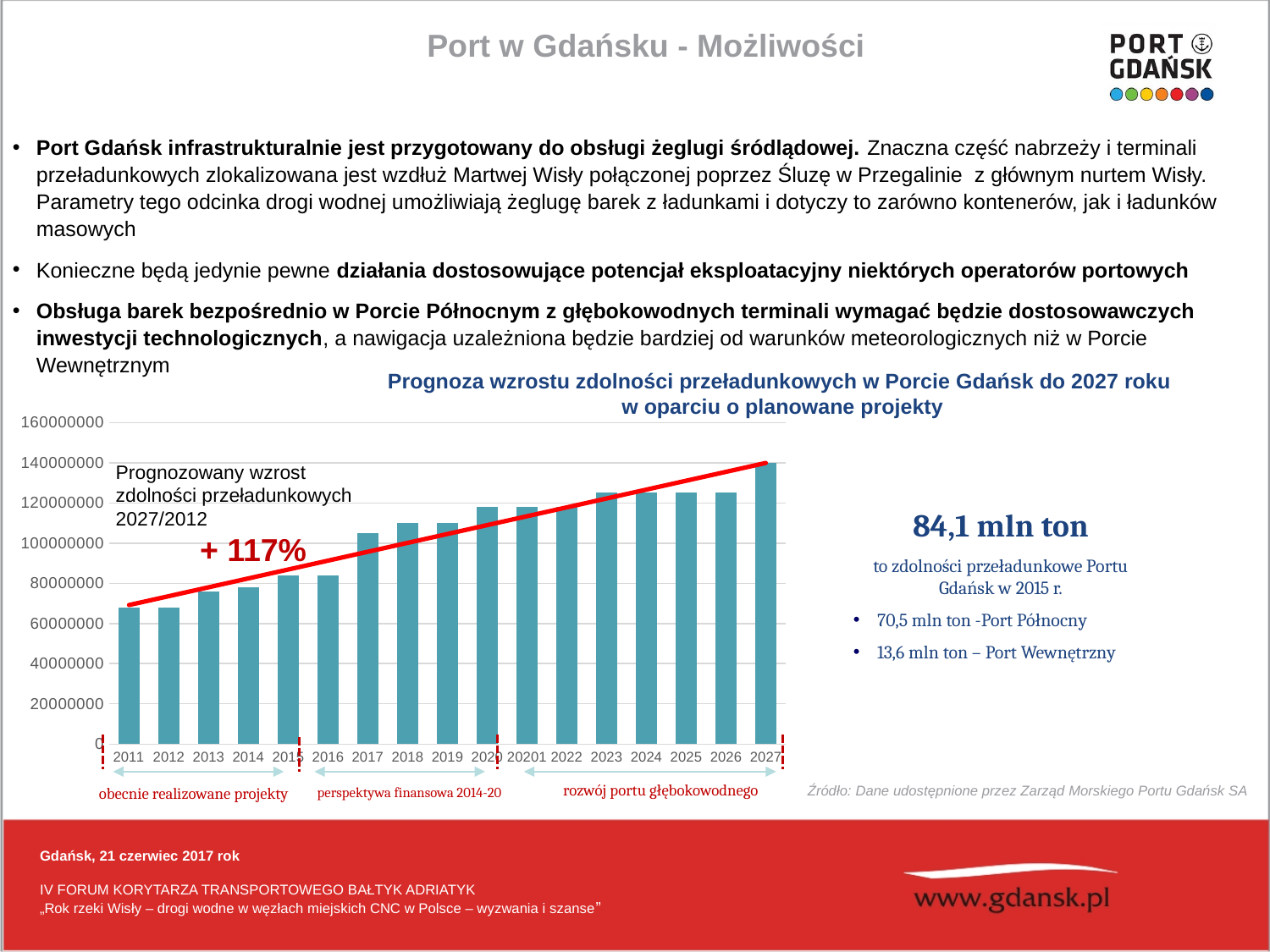
What percentage growth in handling capacity for 2027/2012 is annotated on the chart? + 117% What is the highest value shown on the chart's vertical axis? 160000000 How many years (bars) are plotted on the chart? 17 Is the value for 2016 greater or less than 100000000? less Which year has the larger value, 2013 or 2023? 2023 Which year has the highest bar on the chart? 2027 Do the values generally rise or fall from 2011 to 2027? rise Is the value for 2011 greater or less than 80000000? less Is the value for 2017 greater or less than 100000000? greater What kind of chart is shown on the slide? bar chart Which year has the larger value, 2015 or 2017? 2017